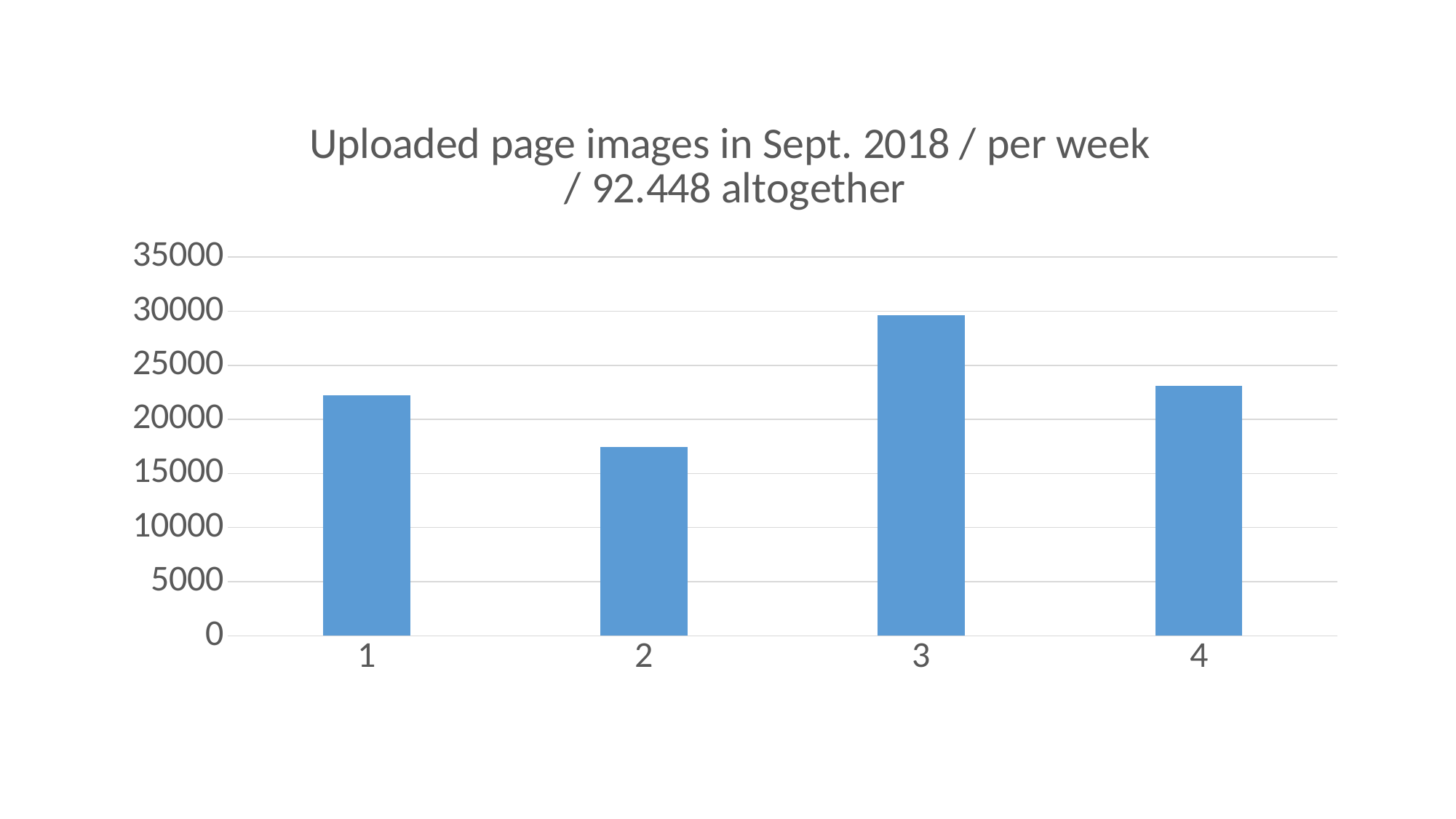
Is the value for week 2 greater or less than 20000? less What kind of chart is shown on the slide? bar chart What is the title of the chart? Uploaded page images in Sept. 2018 / per week / 92.448 altogether Which week has the highest number of uploaded page images? 3 Which week has the lowest number of uploaded page images? 2 Is the value for week 3 greater or less than 25000? greater According to the chart title, how many page images were uploaded altogether in Sept. 2018? 92.448 Is the value for week 1 greater or less than 20000? greater Which week has more uploaded page images, week 3 or week 2? 3 Which week has more uploaded page images, week 1 or week 2? 1 How many bars (weeks) are plotted in the chart? 4